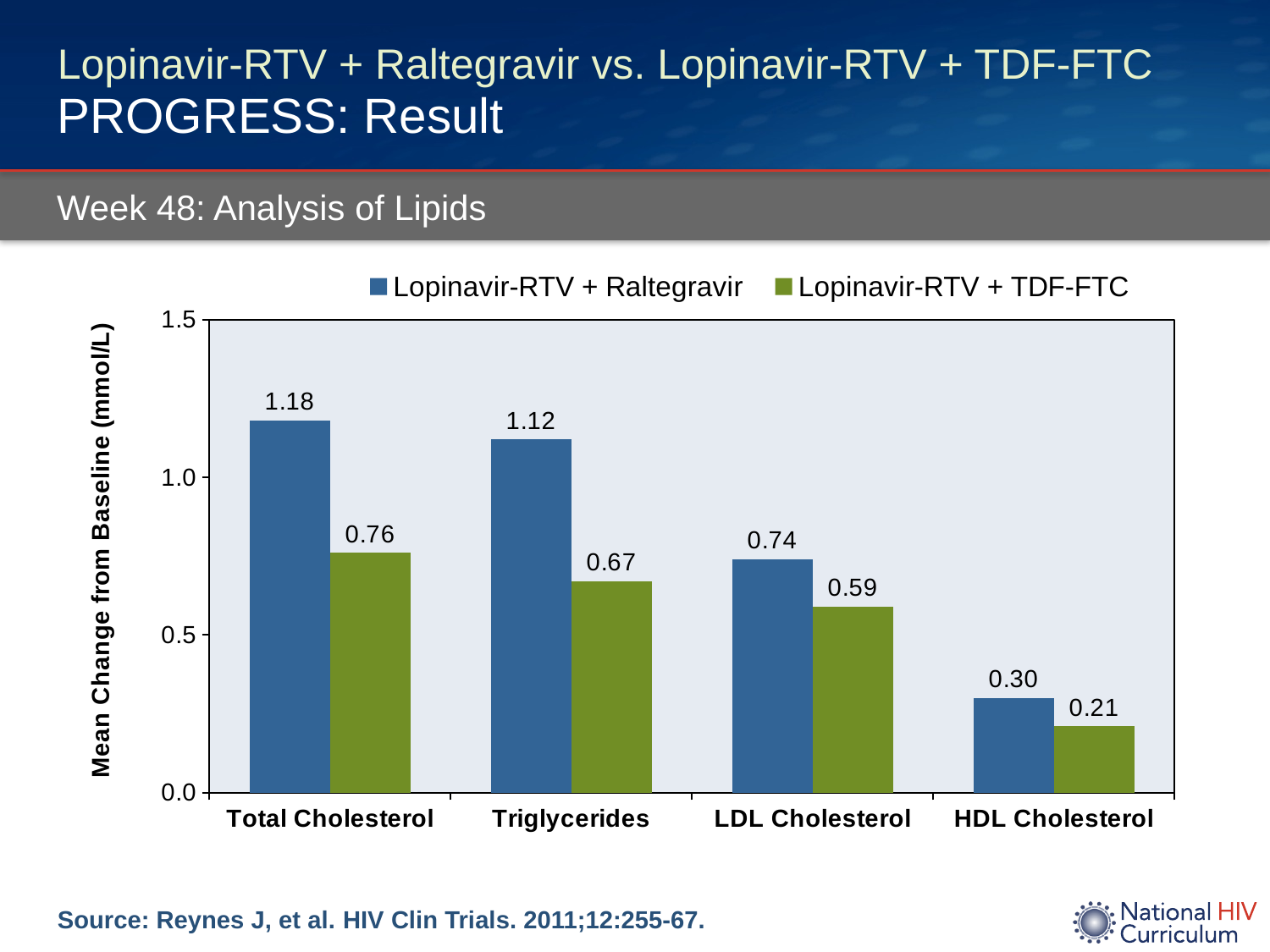
How many series does the legend list? 2 What is the mean change from baseline in Triglycerides for the Lopinavir-RTV + TDF-FTC group? 0.67 What is the mean change from baseline in HDL Cholesterol for the Lopinavir-RTV + Raltegravir group? 0.30 What is the difference between the two groups' mean change in LDL Cholesterol? 0.15 Which group has the larger mean change from baseline in Triglycerides? Lopinavir-RTV + Raltegravir Which lipid category has the lowest value for the Lopinavir-RTV + Raltegravir group? HDL Cholesterol What is the label of the y axis? Mean Change from Baseline (mmol/L) What is the mean change from baseline in Total Cholesterol for the Lopinavir-RTV + Raltegravir group? 1.18 How many lipid categories are shown on the x axis? 4 Is the value for HDL Cholesterol in the Lopinavir-RTV + TDF-FTC group greater or less than 0.5? less What kind of chart is shown on the slide? Bar chart Which lipid category has the highest value for the Lopinavir-RTV + TDF-FTC group? Total Cholesterol